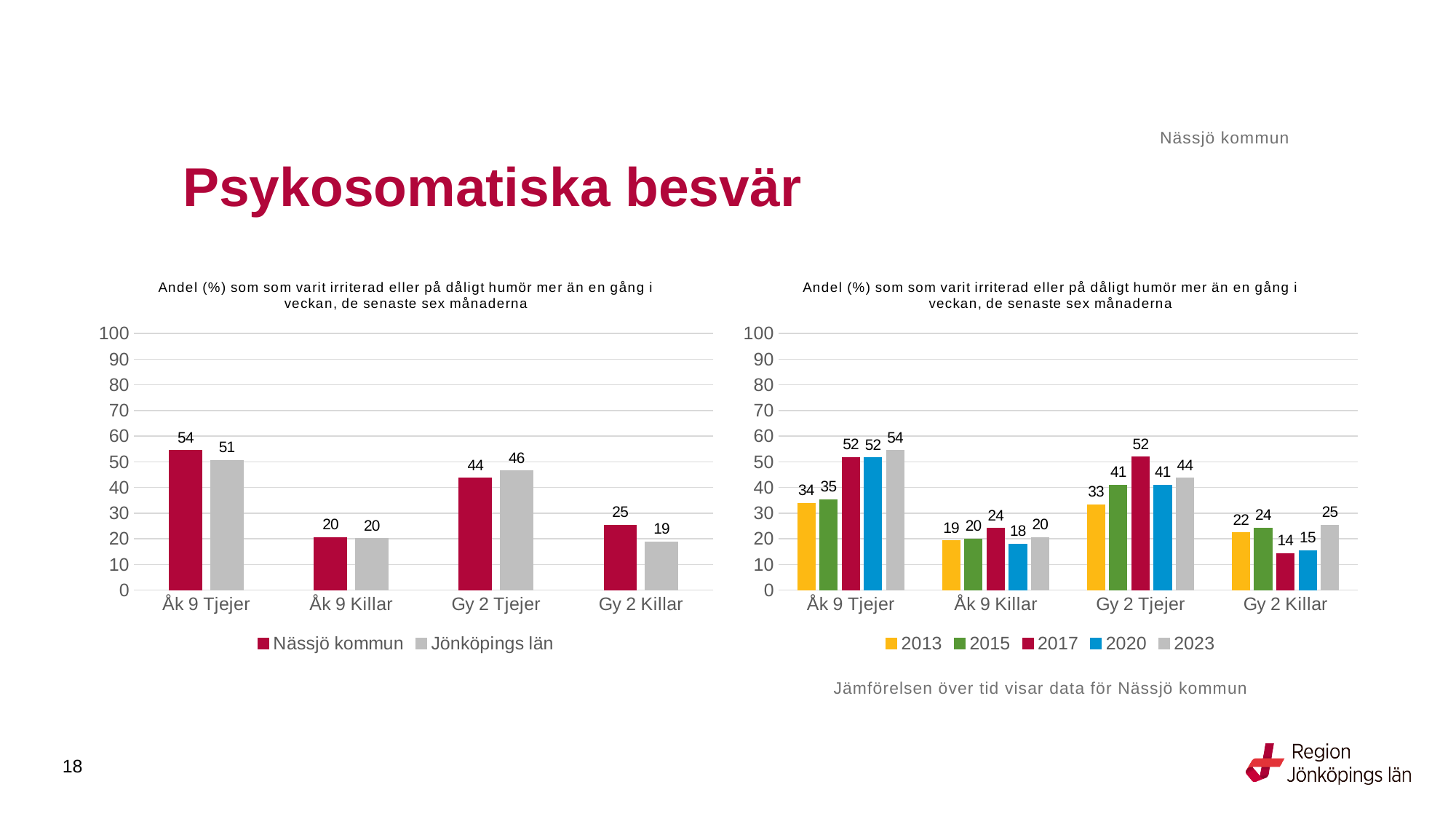
In the left chart, what is the difference between Nässjö kommun and Jönköpings län for Gy 2 Tjejer? 2 In the right chart, what is the difference between the 2013 and 2023 values for Åk 9 Tjejer? 20 In the left chart, what is the value for Jönköpings län for Gy 2 Killar? 19 In the left chart, what is the value for Nässjö kommun for Åk 9 Tjejer? 54 In the left chart, which category has the lowest value for Jönköpings län? Gy 2 Killar In the left chart, how many series does the legend list? 2 In the right chart, which year has the lowest value for Gy 2 Killar? 2017 In the right chart, how many series does the legend list? 5 What kind of chart is the right chart? Bar chart In the right chart, what is the value for 2017 for Gy 2 Tjejer? 52 In the right chart, which year has the highest value for Åk 9 Tjejer? 2023 In the right chart, what is the value for 2020 for Gy 2 Killar? 15